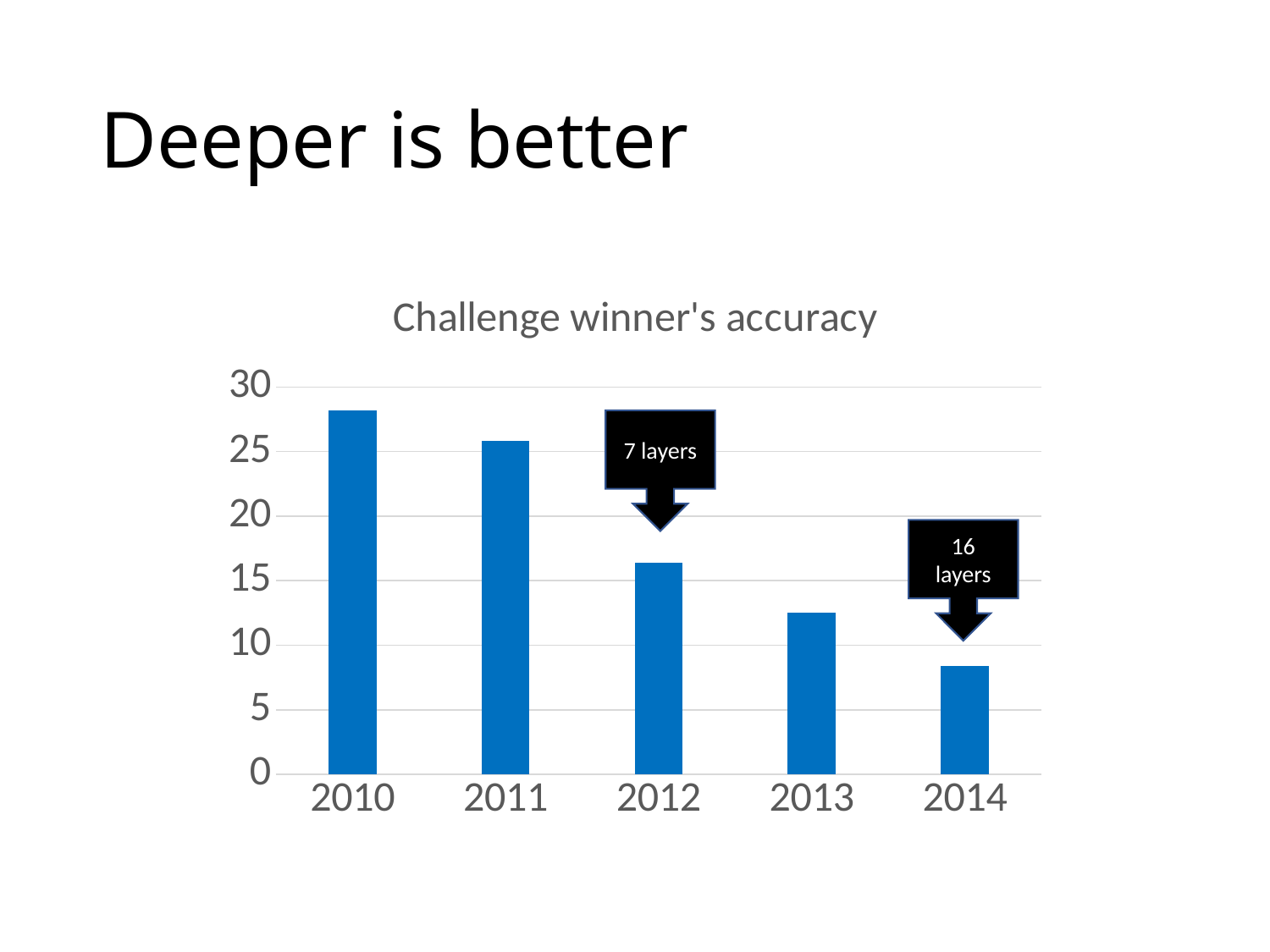
What is the title of the chart? Challenge winner's accuracy Which is larger, the value for 2011 or the value for 2013? 2011 According to the annotation on the chart, how many layers are noted for the 2014 bar? 16 layers Do the values rise or fall from 2010 to 2014? fall What kind of chart is shown on the slide? bar chart Is the value for 2010 greater or less than 25? greater Is the value for 2014 greater or less than 10? less Is the value for 2012 greater or less than 20? less Which year has the highest bar in the chart? 2010 Which year has the lowest bar in the chart? 2014 How many years are shown on the x axis of the chart? 5